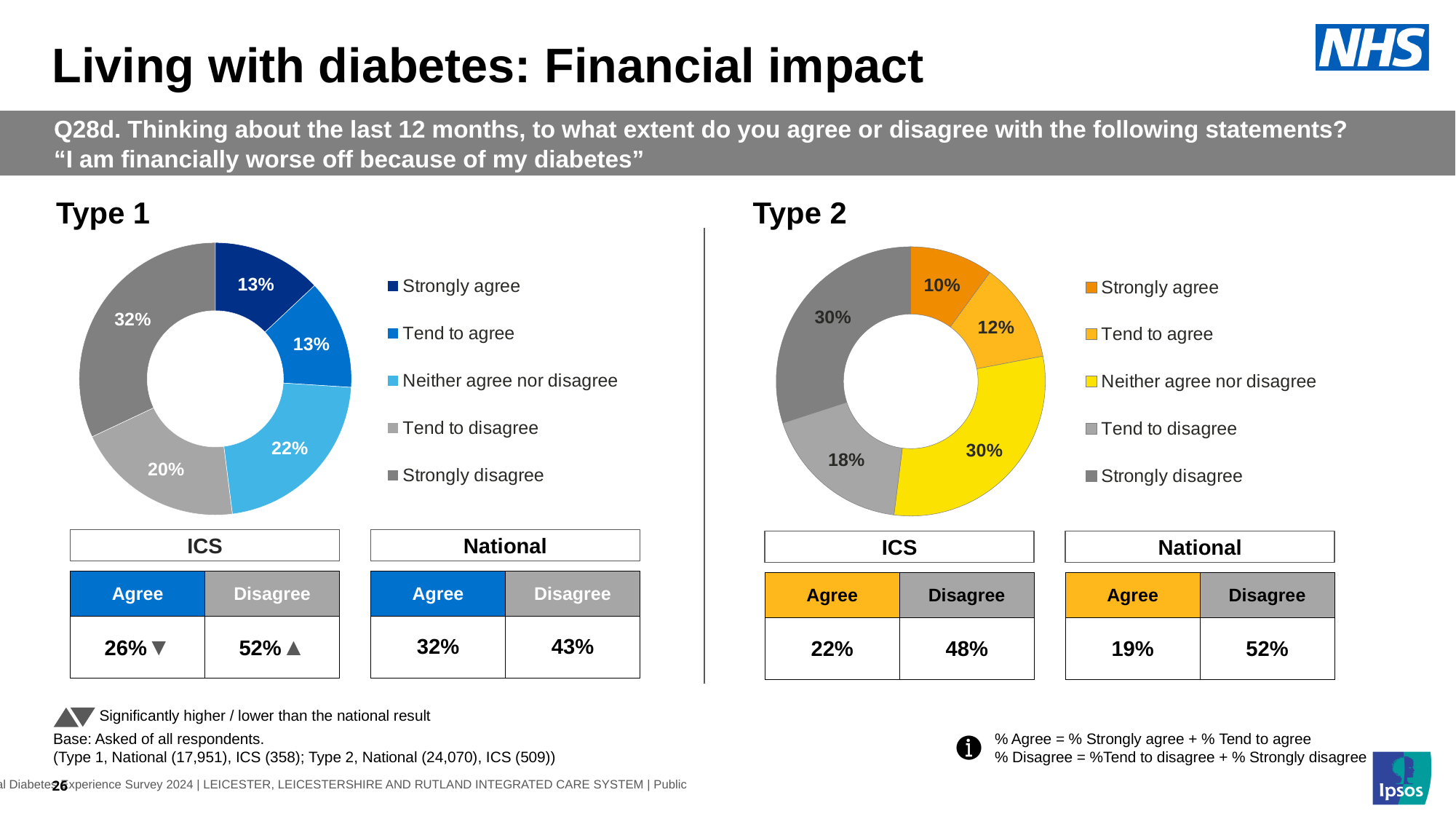
In the Type 2 chart, what is the combined share of Strongly agree and Tend to agree? 22% In the Type 1 chart, what is the difference between the Strongly disagree share and the Tend to disagree share? 12 percentage points In the Type 2 chart, what percentage of respondents said they tend to agree? 12% In the Type 1 chart, what percentage neither agree nor disagree? 22% In the Type 2 chart, which response category has the smallest share? Strongly agree What colour is the Neither agree nor disagree segment in the Type 2 chart? Yellow In the Type 1 chart, what percentage of respondents said they strongly disagree? 32% In the Type 2 chart, what percentage said they tend to disagree? 18% How many response categories does the legend of the Type 2 chart list? 5 What type of chart is used for the Type 1 results? Donut (pie) chart In the Type 1 chart, which response category has the largest share? Strongly disagree In the Type 2 chart, which is larger: the Neither agree nor disagree share or the Tend to disagree share? Neither agree nor disagree